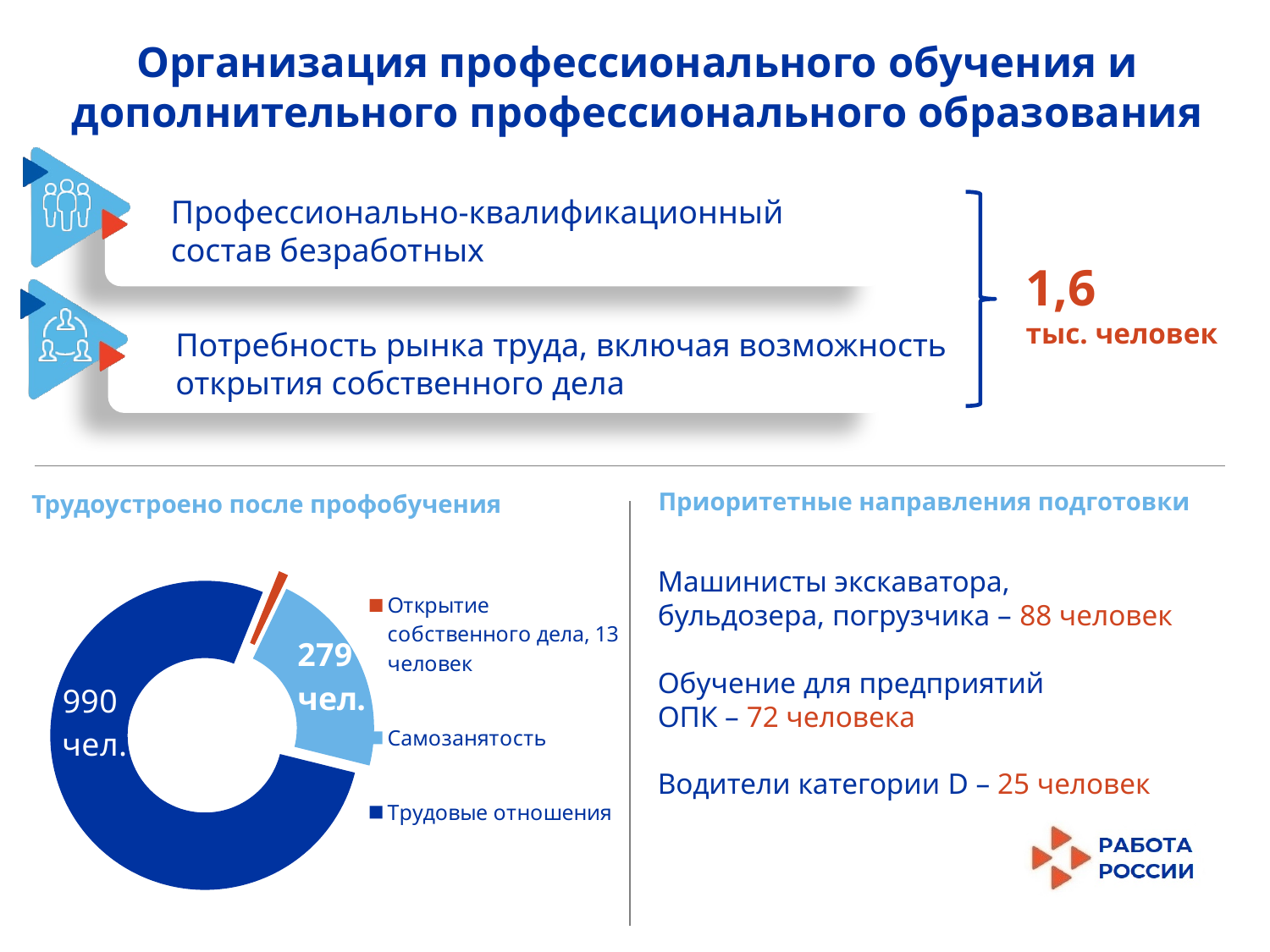
How many categories does the chart "Трудоустроено после профобучения" show? 3 In the chart "Трудоустроено после профобучения", what is the total number of people across all three segments? 1282 In the chart "Трудоустроено после профобучения", which is larger: "Самозанятость" or "Открытие собственного дела"? Самозанятость In the chart "Трудоустроено после профобучения", how many people are in the "Открытие собственного дела" segment? 13 человек What is the title of the chart on the left side of the slide? Трудоустроено после профобучения In the chart "Трудоустроено после профобучения", which category has the smallest segment? Открытие собственного дела In the chart "Трудоустроено после профобучения", what value is shown for "Самозанятость"? 279 чел. In the chart "Трудоустроено после профобучения", how many more people are in "Трудовые отношения" than in "Самозанятость"? 711 In the chart "Трудоустроено после профобучения", how many people are in the "Трудовые отношения" segment? 990 чел. What type of chart is "Трудоустроено после профобучения"? Doughnut chart In the chart "Трудоустроено после профобучения", which category has the largest segment? Трудовые отношения In the chart "Трудоустроено после профобучения", what is the difference between "Самозанятость" and "Открытие собственного дела"? 266